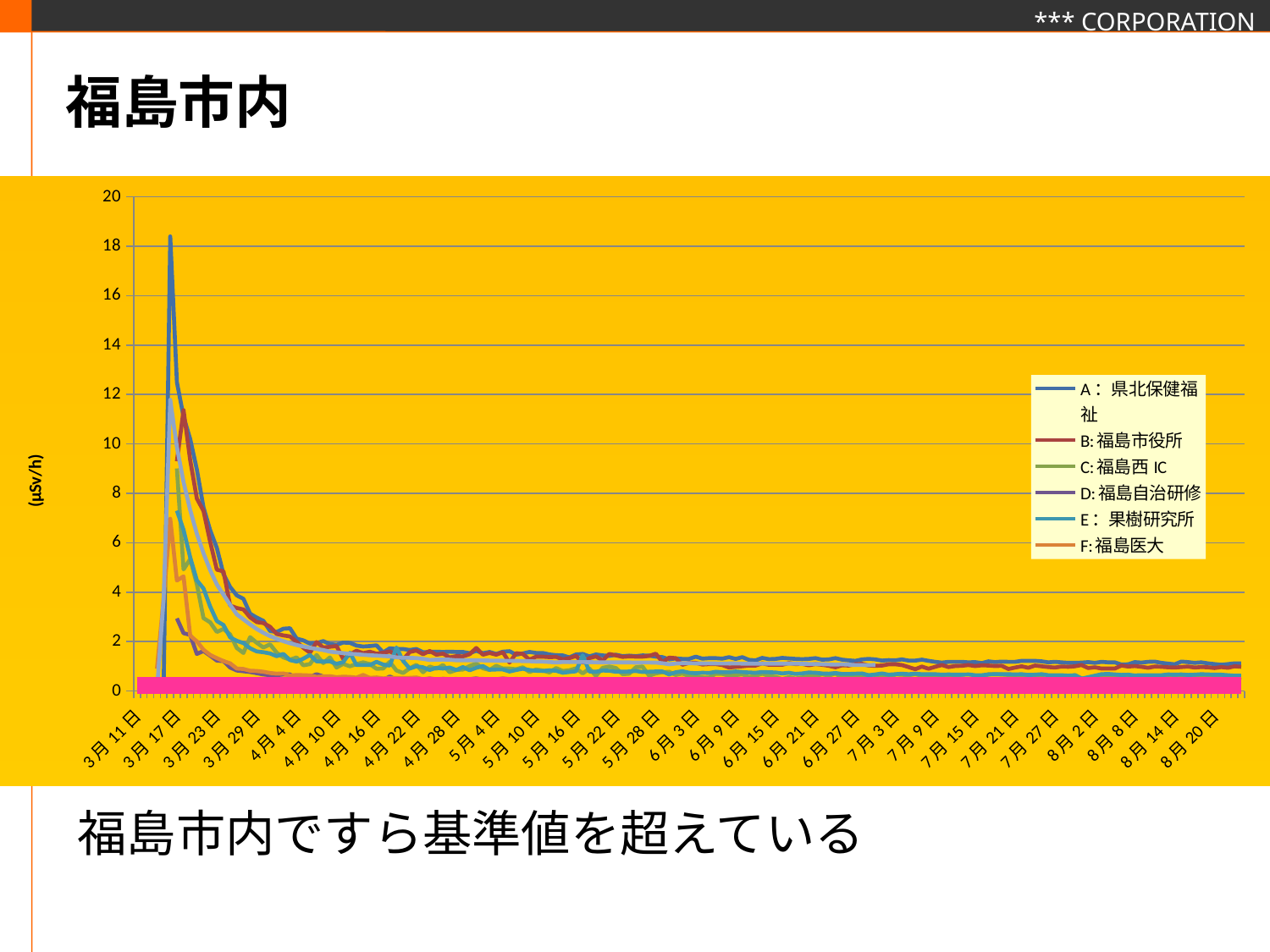
What is the unit shown on the y axis? μSv/h Is the peak value of series B (福島市役所) greater or less than 10? greater Which series reaches the highest peak value on the chart? A: 県北保健福祉 What is the first date label on the x axis? 3月11日 Is the peak value of series F (福島医大) greater or less than 10? less Do the values generally rise or fall along the x axis after the peak in mid-March? fall Which series is labelled C in the legend? 福島西 IC What is the maximum value shown on the y axis? 20 Is the peak value of series A (県北保健福祉) greater or less than 16? greater How many series does the legend list? 6 What kind of chart is shown on the slide? line chart